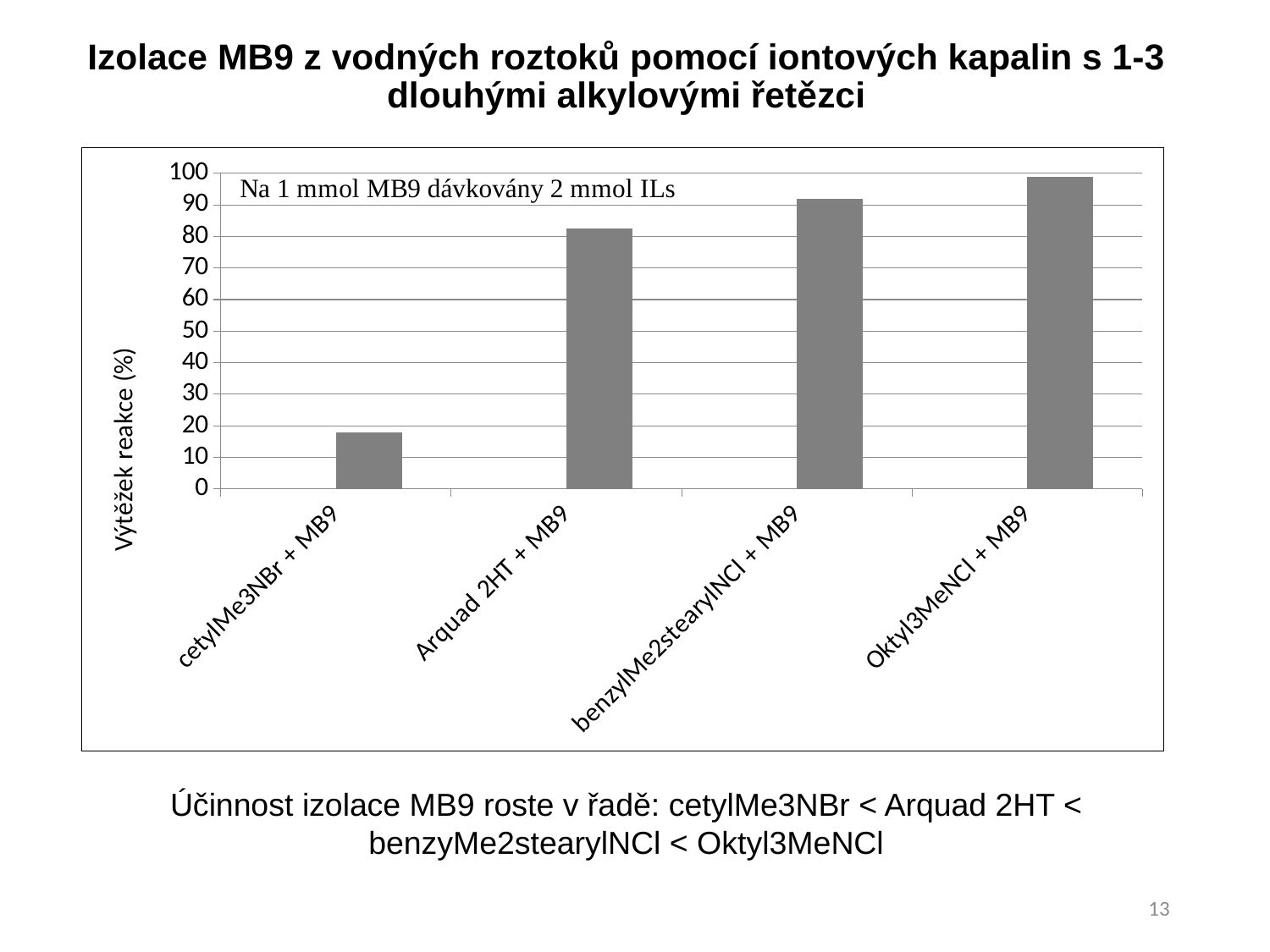
What is the label of the vertical axis of the chart? Výtěžek reakce (%) Which category has the lowest value in the chart? cetylMe3NBr + MB9 Is the value for Arquad 2HT + MB9 greater or less than 80? greater What kind of chart is shown on the slide? bar chart Which category has the highest value in the chart? Oktyl3MeNCl + MB9 Which is larger, the value for cetylMe3NBr + MB9 or the value for Arquad 2HT + MB9? Arquad 2HT + MB9 Do the values rise or fall from left to right along the x axis? rise Is the value for cetylMe3NBr + MB9 greater or less than 20? less Is the value for Oktyl3MeNCl + MB9 greater or less than 90? greater What text annotation is shown inside the chart area? Na 1 mmol MB9 dávkovány 2 mmol ILs How many categories (bars) are plotted in the chart? 4